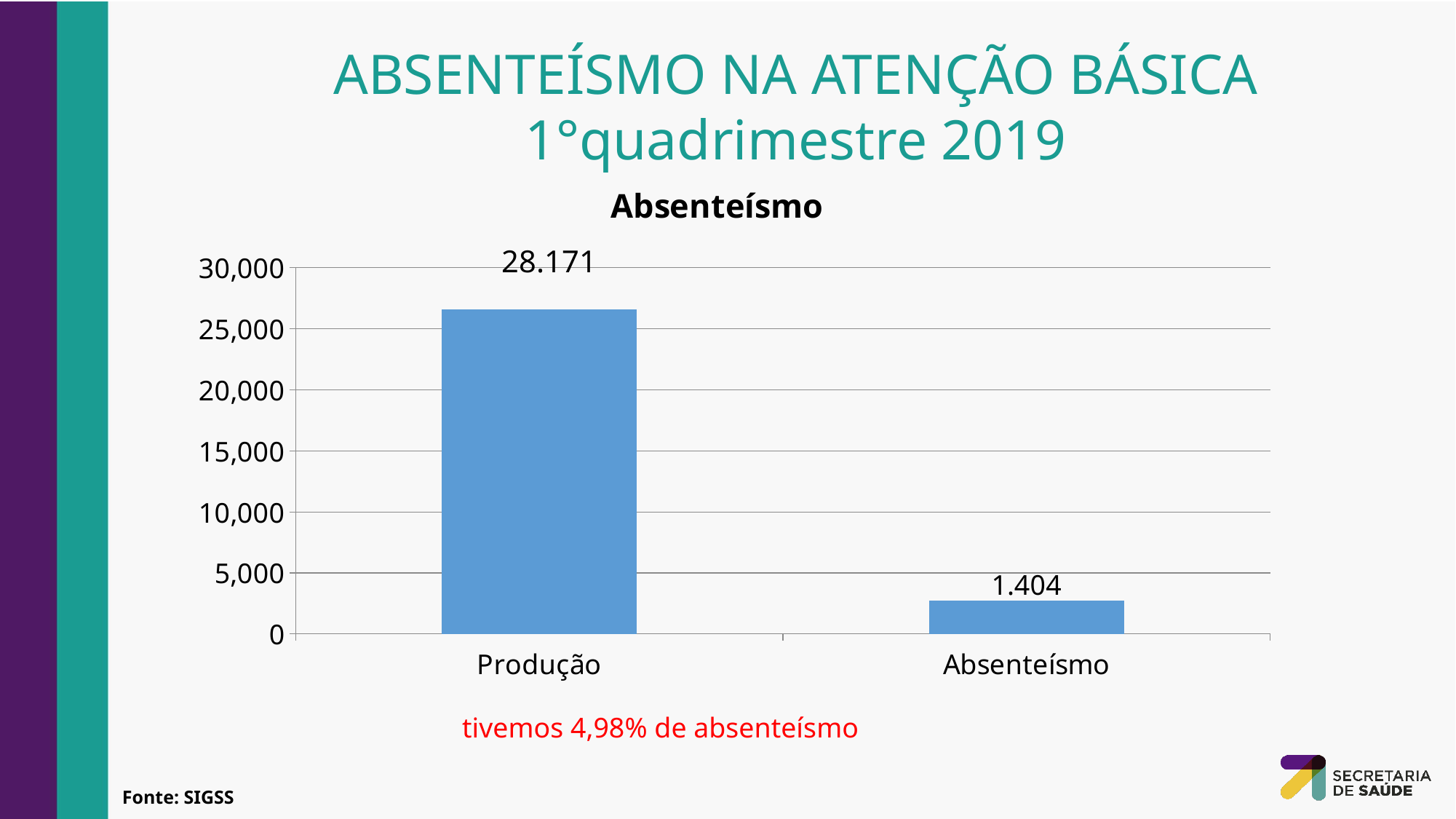
What is the difference between the values for Produção and Absenteísmo? 26.767 Which category has the lowest value? Absenteísmo What is the value shown for Produção? 28.171 What is the title of the chart? Absenteísmo What is the highest value labelled on the y axis? 30,000 Is the value for Produção greater or less than 25,000? greater Which category has the highest value? Produção How many categories are shown on the x axis? 2 What is the value shown for Absenteísmo? 1.404 Which is larger, the value for Produção or the value for Absenteísmo? Produção What kind of chart is shown on the slide? bar chart Is the value for Absenteísmo greater or less than 5,000? less